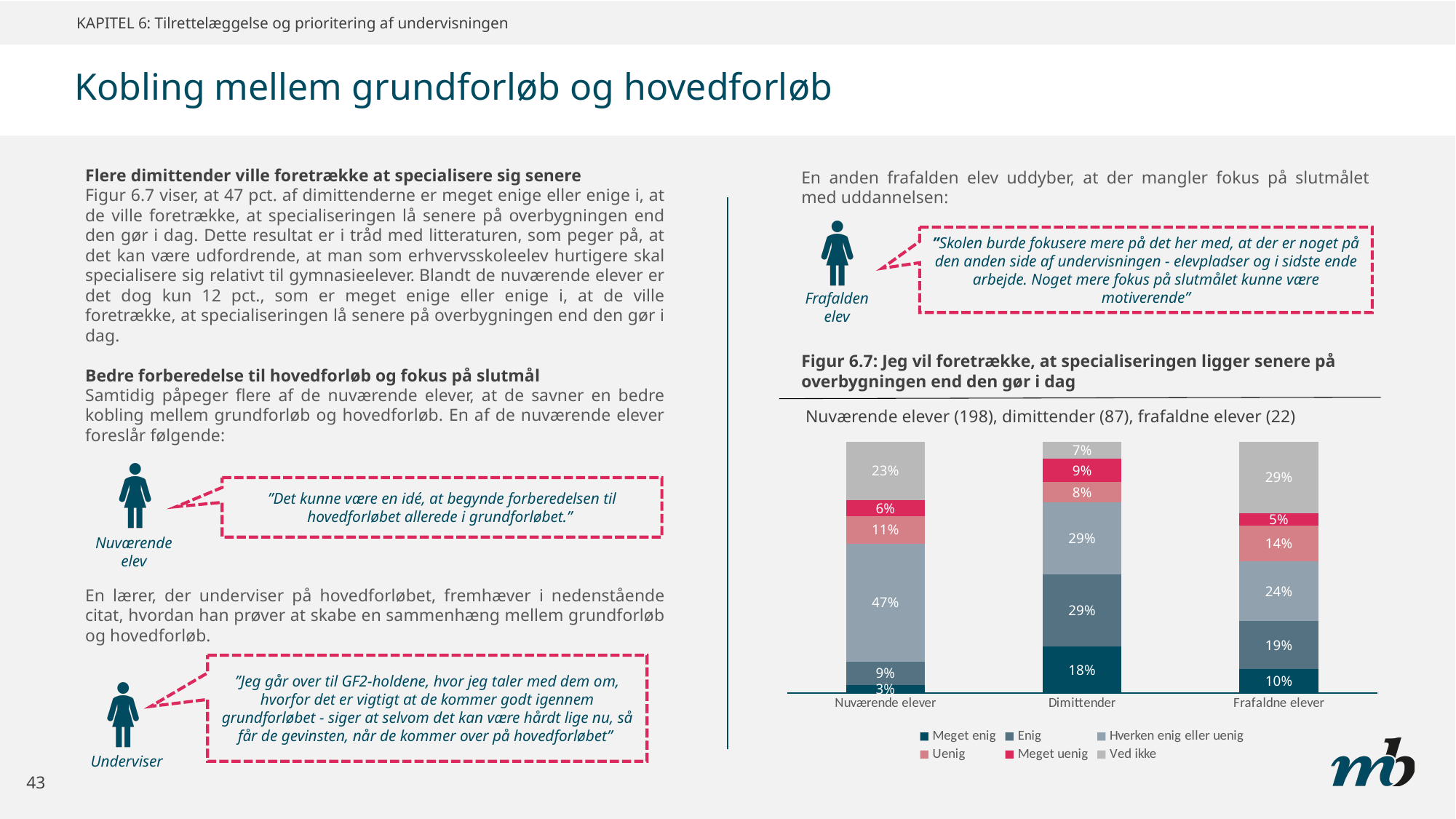
In Figur 6.7, which group has the highest share of 'Meget enig' responses? Dimittender In Figur 6.7, what is the difference between the 'Enig' share for Dimittender and for Nuværende elever? 20 percentage points According to the subtitle of Figur 6.7, how many Dimittender responded? 87 In Figur 6.7, what percentage of Dimittender answered 'Meget enig'? 18% In Figur 6.7, what percentage of Nuværende elever answered 'Hverken enig eller uenig'? 47% In Figur 6.7, which group has the lowest share of 'Ved ikke' responses? Dimittender How many response categories does the legend of Figur 6.7 list? 6 In Figur 6.7, is the 'Uenig' share larger for Frafaldne elever or for Dimittender? Frafaldne elever How many groups (bars) are shown in Figur 6.7? 3 In Figur 6.7, what percentage of Nuværende elever answered 'Meget enig'? 3% In Figur 6.7, what percentage of Frafaldne elever answered 'Ved ikke'? 29% What type of chart is shown in Figur 6.7? Stacked bar chart